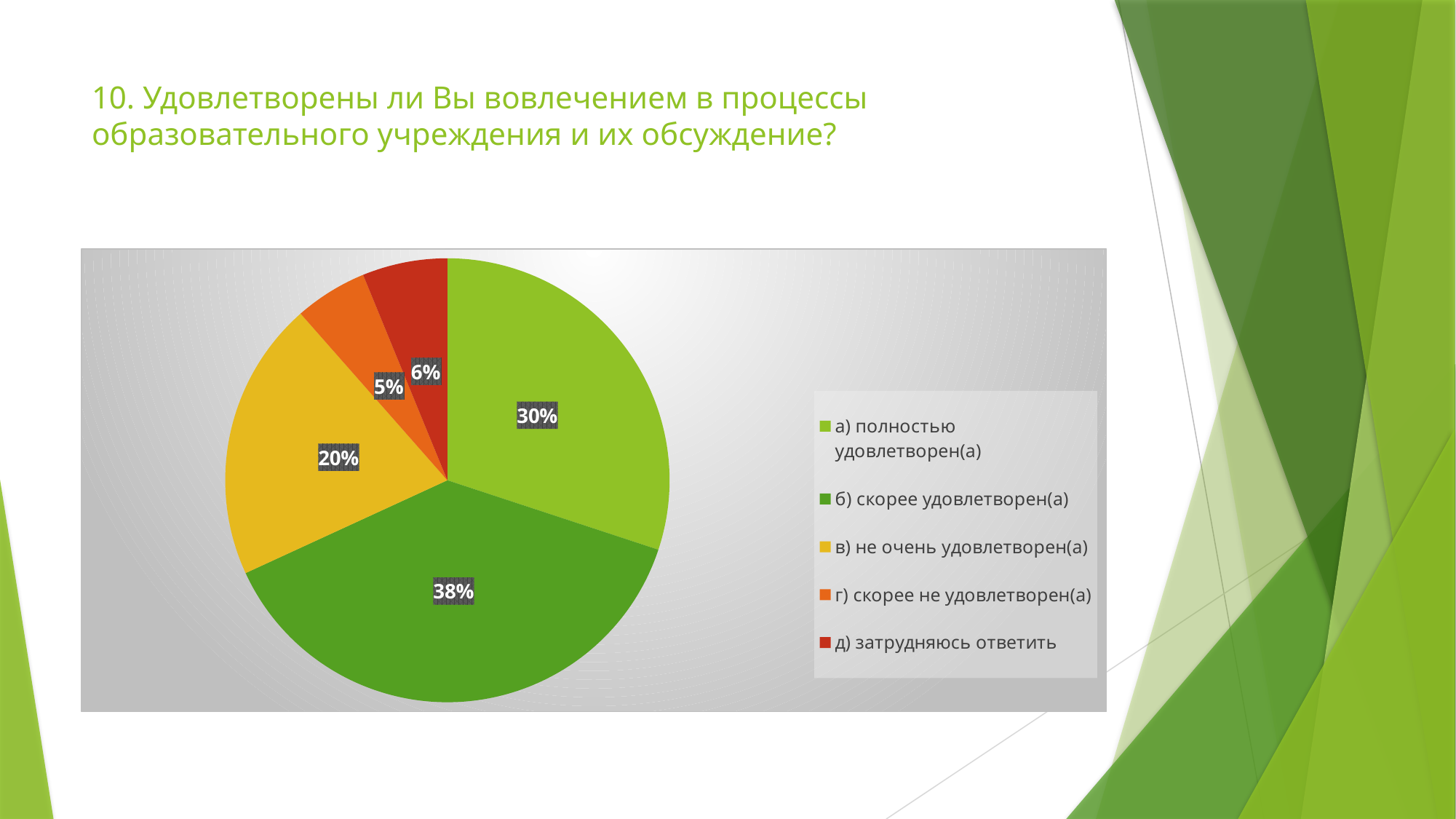
What share of the pie does "в) не очень удовлетворен(а)" have? 20% What kind of chart is shown on the slide? pie chart Which is larger: the share for "в) не очень удовлетворен(а)" or for "д) затрудняюсь ответить"? в) не очень удовлетворен(а) What share of the pie does "г) скорее не удовлетворен(а)" have? 5% What share of the pie does "а) полностью удовлетворен(а)" have? 30% How many categories does the pie chart have? 5 Which category has the smallest slice of the pie? г) скорее не удовлетворен(а) What is the difference between the shares of "б) скорее удовлетворен(а)" and "а) полностью удовлетворен(а)"? 8% Which category has the largest slice of the pie? б) скорее удовлетворен(а) What colour is the slice for "д) затрудняюсь ответить"? red